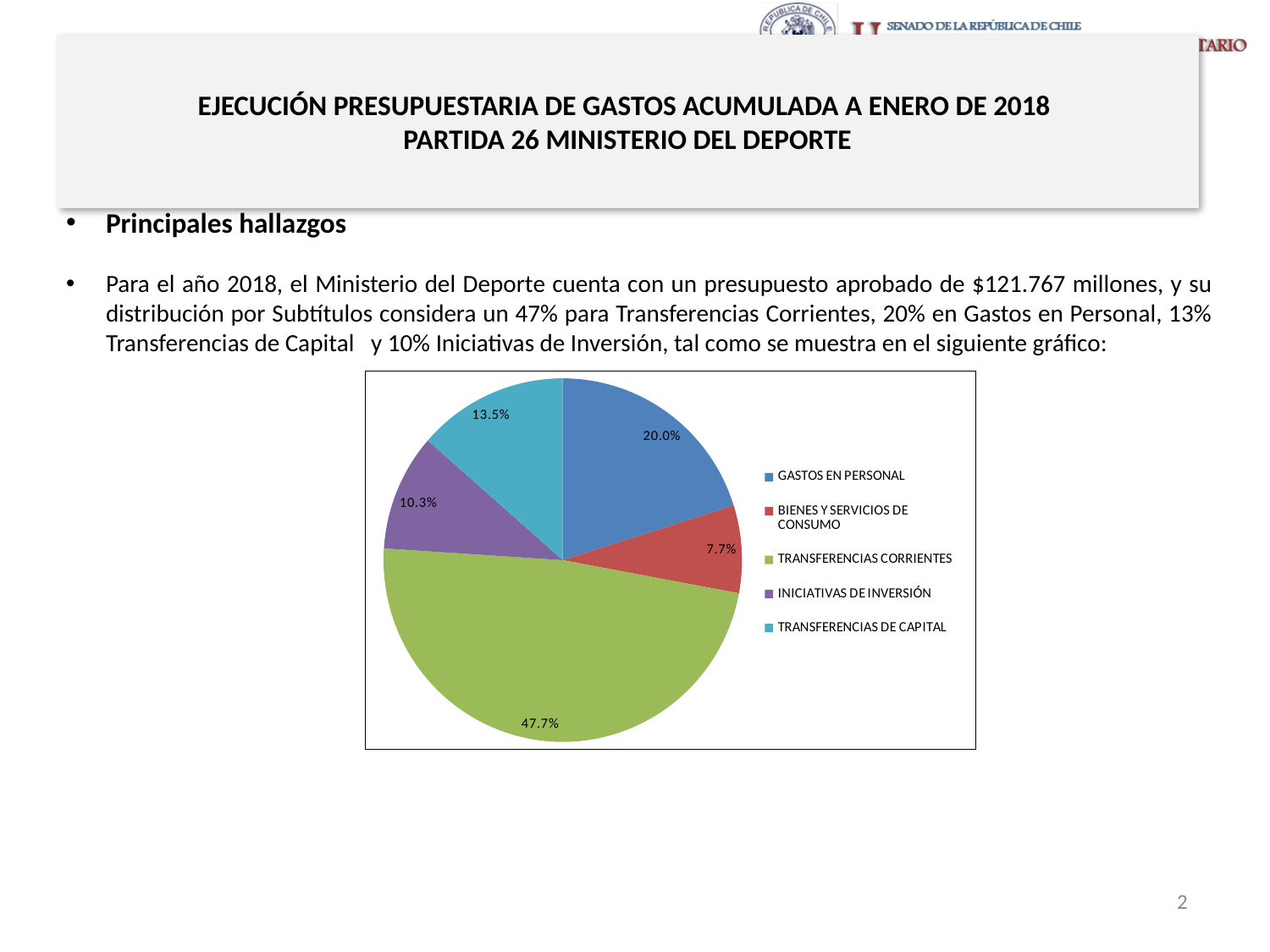
What is the value shown for INICIATIVAS DE INVERSIÓN? 10.3% Which category has the largest slice of the pie? TRANSFERENCIAS CORRIENTES What share of the pie does TRANSFERENCIAS CORRIENTES represent? 47.7% What is the value shown for BIENES Y SERVICIOS DE CONSUMO? 7.7% Which is larger, the share for INICIATIVAS DE INVERSIÓN or the share for TRANSFERENCIAS DE CAPITAL? TRANSFERENCIAS DE CAPITAL What is the difference between the shares of GASTOS EN PERSONAL and TRANSFERENCIAS DE CAPITAL? 6.5% What kind of chart is shown on the slide? pie chart What is the value shown for GASTOS EN PERSONAL? 20.0% How many categories does the pie chart show? 5 Which category has the smallest slice of the pie? BIENES Y SERVICIOS DE CONSUMO What is the value shown for TRANSFERENCIAS DE CAPITAL? 13.5% What colour is the slice for TRANSFERENCIAS CORRIENTES? green